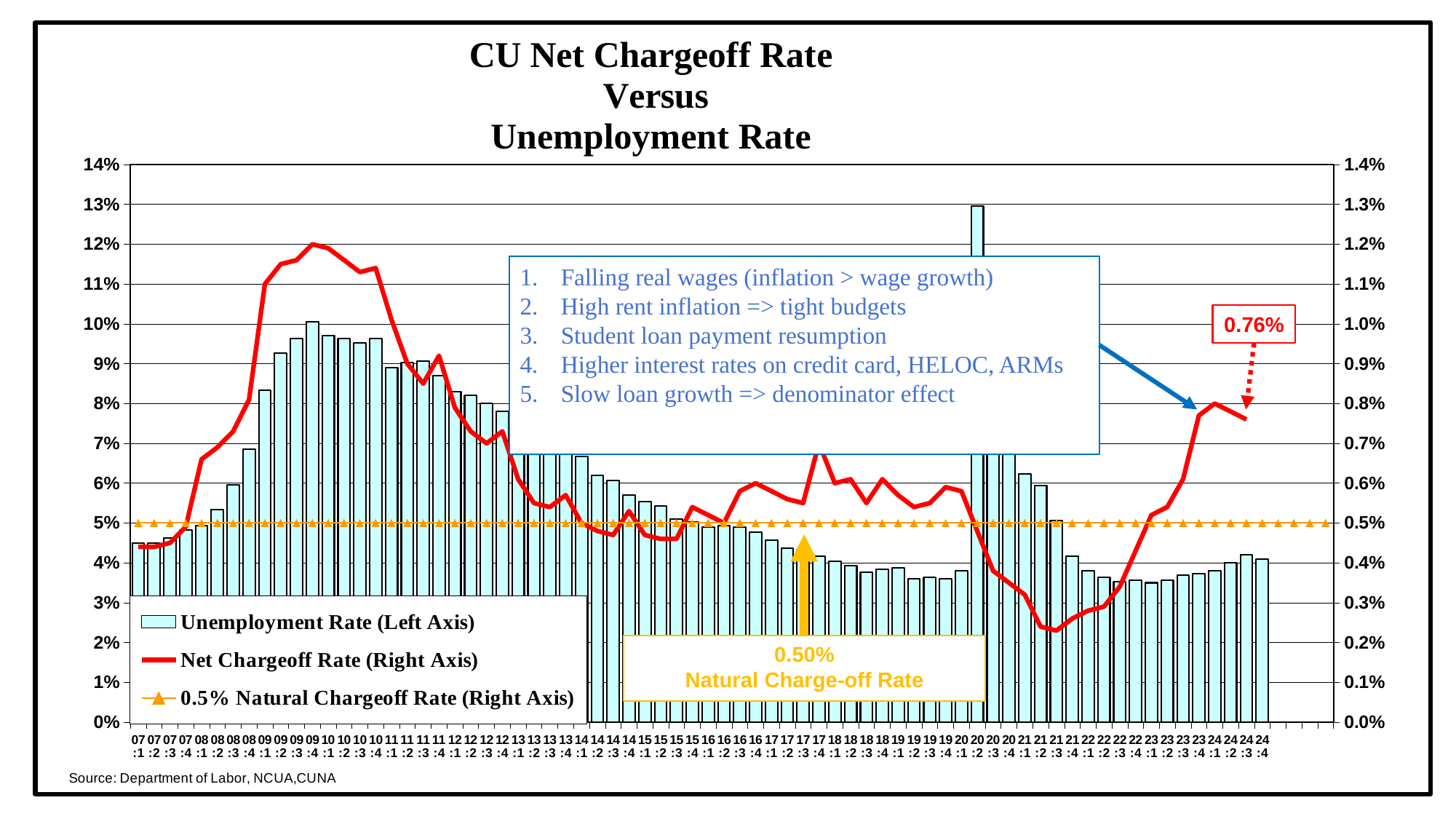
What is the labelled value of the Net Chargeoff Rate at the end of the series (24:4)? 0.76% How many series does the legend list? 3 Which is larger, the Unemployment Rate for 10:1 or for 19:1? 10:1 What kind of chart is this? Combined bar and line chart Is the Net Chargeoff Rate for 09:4 greater or less than 1.1%? greater Is the Unemployment Rate for 09:4 greater or less than 9%? greater Does the Net Chargeoff Rate rise or fall from 21:3 to 23:4? rise Which quarter has the highest Unemployment Rate? 20:2 Is the Net Chargeoff Rate for 21:3 greater or less than 0.3%? less What is the value of the Natural Charge-off Rate line? 0.50% What is the title of the chart? CU Net Chargeoff Rate Versus Unemployment Rate